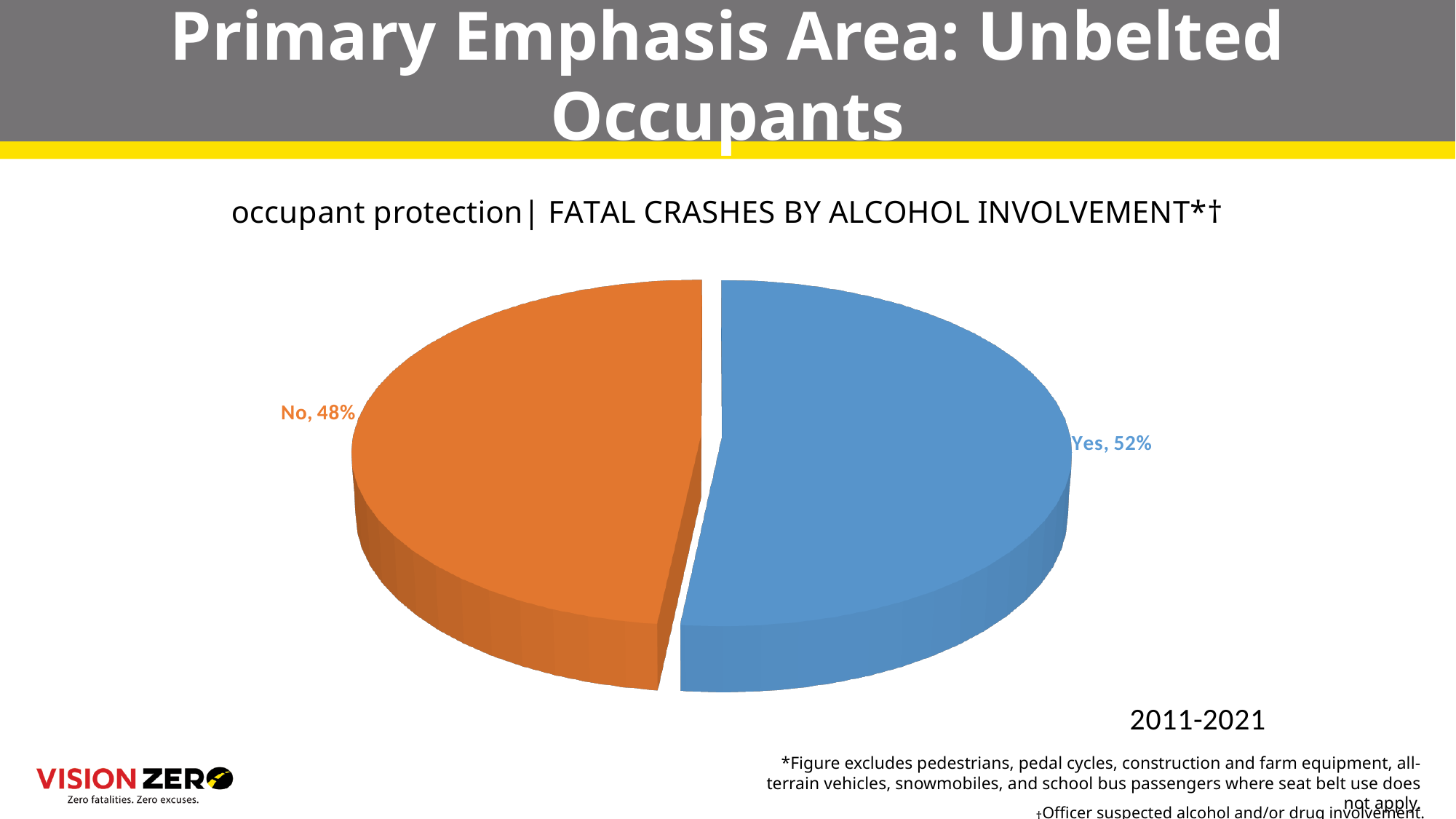
What is the difference in percentage points between the Yes and No slices? 4 percentage points What share of fatal crashes did not involve alcohol (No)? 48% What share of fatal crashes involved alcohol (Yes)? 52% Is the share for Yes greater or less than 50%? greater Which category has the largest share of the pie? Yes How many slices does the pie chart have? 2 Which slice of the pie is larger, Yes or No? Yes What type of chart is shown on the slide? Pie chart What time period does the chart cover? 2011-2021 What colour is the No slice of the pie? Orange What is the title of the chart? occupant protection | FATAL CRASHES BY ALCOHOL INVOLVEMENT*† Which category has the smallest share of the pie? No